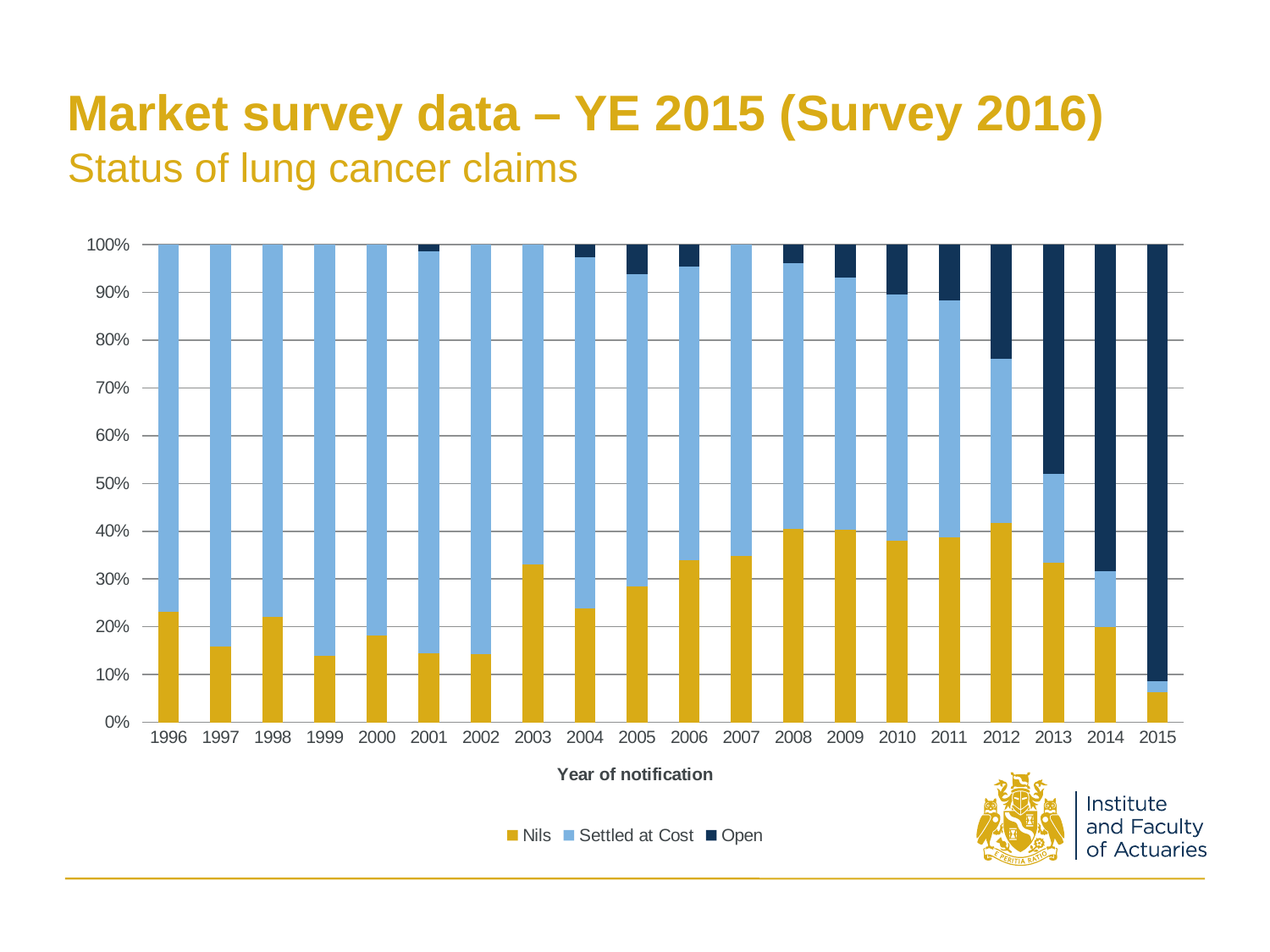
How many years of notification are shown on the x axis? 20 What is the title of the x axis? Year of notification Is the Nils share for 2015 greater or less than 10%? less Which year has the smallest Nils share? 2015 Which year has the larger Nils share, 1996 or 1997? 1996 Is the Nils share for 1999 greater or less than 20%? less What kind of chart is shown on the slide? Stacked bar chart What are the three series listed in the legend? Nils, Settled at Cost, Open Which year has the largest Open share? 2015 Does the Open share generally rise or fall from 1996 to 2015? rise How many series does the legend list? 3 Is the Open share for 2013 greater or less than 40%? greater